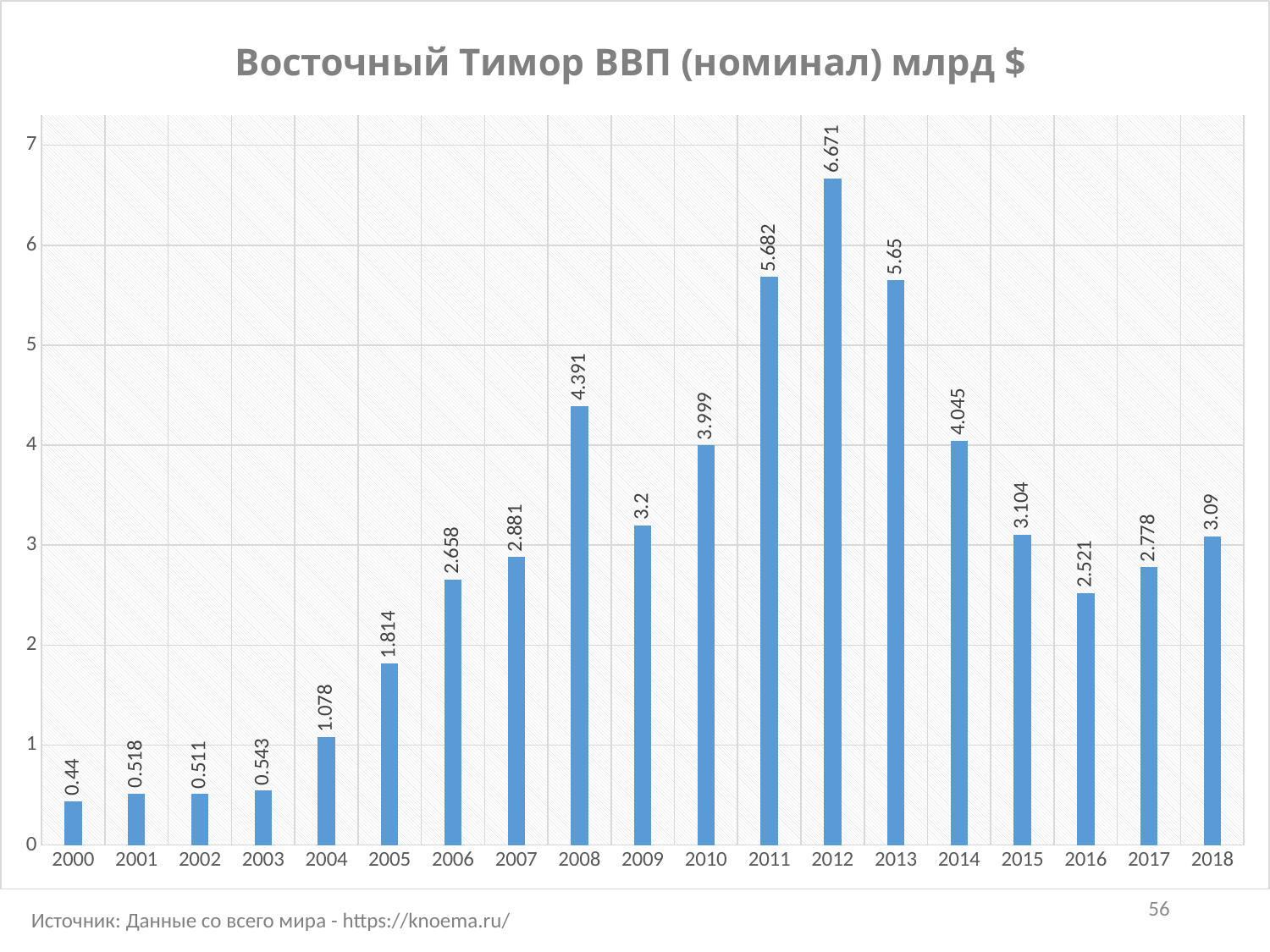
Which year has the highest value? 2012 Which is larger, the value for 2008 or the value for 2010? 2008 What is the value for 2005? 1.814 What is the value for 2018? 3.09 Do the values rise or fall from 2000 to 2008? rise What kind of chart is this? bar chart How many years are shown on the x axis? 19 What is the title of the chart? Восточный Тимор ВВП (номинал) млрд $ What is the difference between the values for 2012 and 2013? 1.021 What is the value for 2012? 6.671 Is the value for 2011 greater or less than 5? greater Which year has the lowest value? 2000